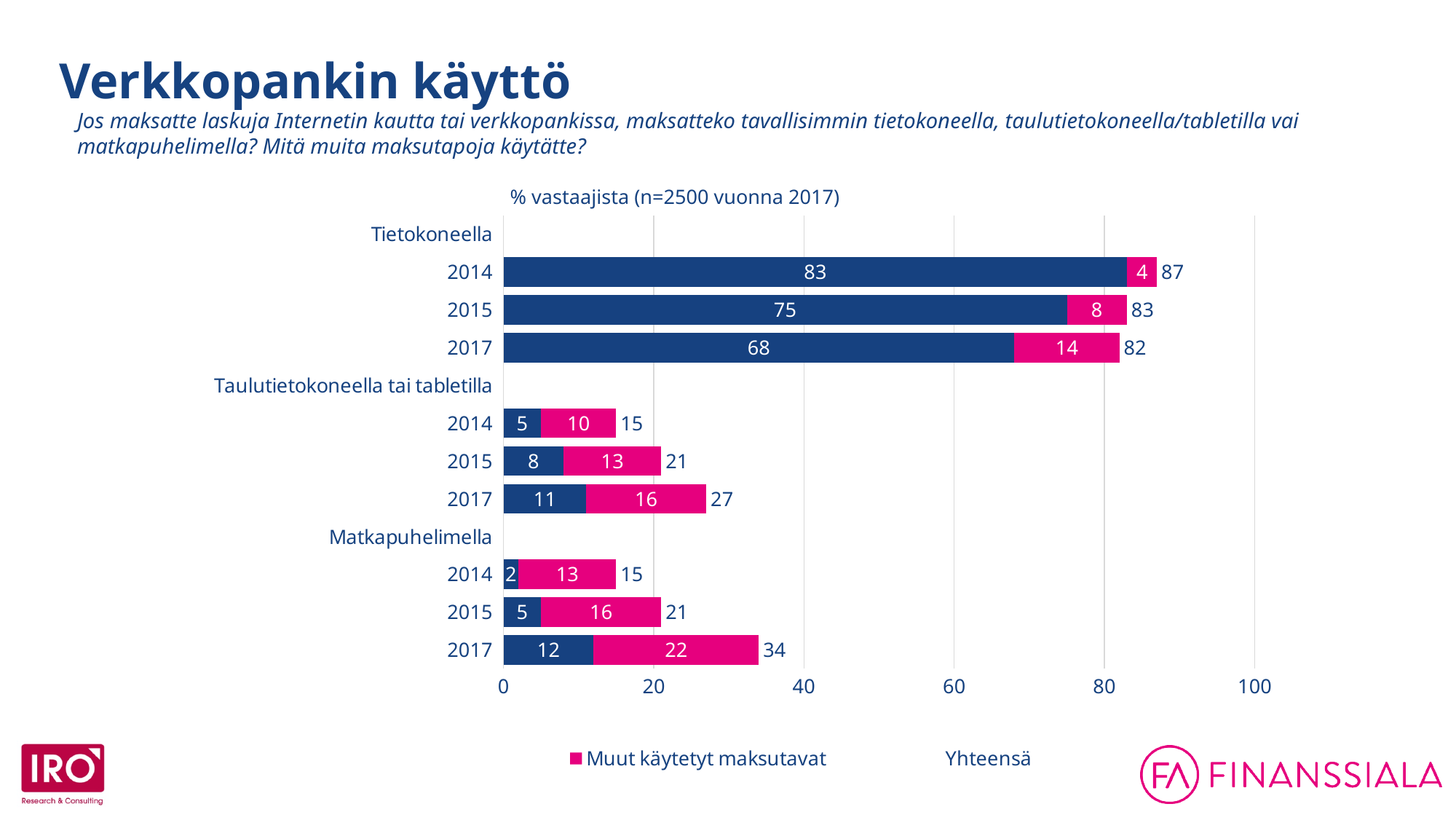
How do the dark blue segment values for Tietokoneella change from 2014 to 2017? They fall How many bars are plotted in the chart? 9 What is the difference between the Tietokoneella totals for 2014 and 2017? 5 Which year has the lowest total for Tietokoneella? 2017 What is the total value for Matkapuhelimella in 2017? 34 What is the total value for Tietokoneella in 2014? 87 What is the chart's title? % vastaajista (n=2500 vuonna 2017) Which year has the highest total for Matkapuhelimella? 2017 What is the value of the dark blue segment for Taulutietokoneella tai tabletilla in 2015? 8 What type of chart is shown on the slide? stacked bar chart What is the value of the 'Muut käytetyt maksutavat' segment for Tietokoneella in 2017? 14 Which is larger: the 2017 total for Taulutietokoneella tai tabletilla or the 2017 total for Matkapuhelimella? Matkapuhelimella